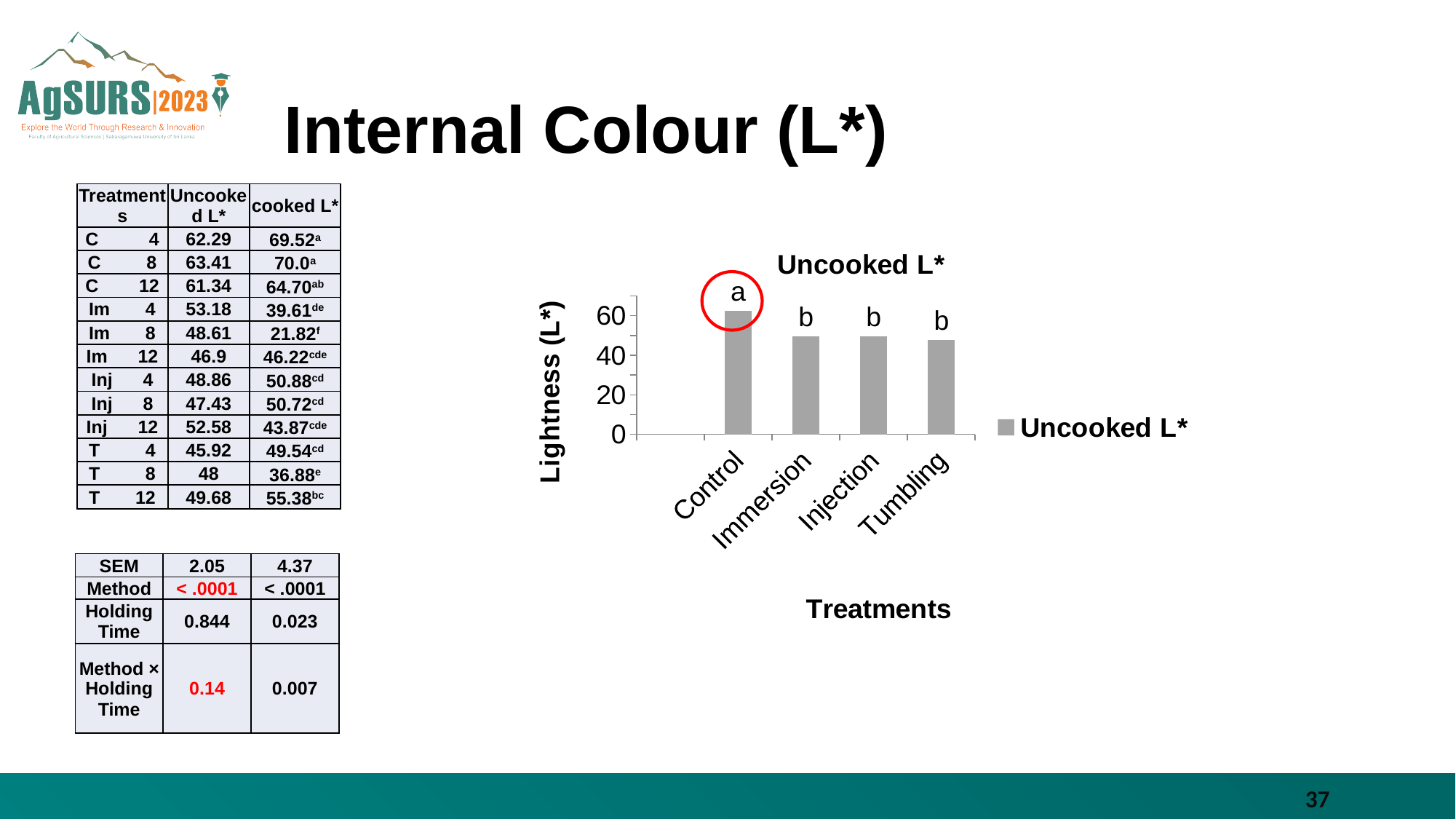
Which treatment has the highest Uncooked L* value in the chart? Control What kind of chart is shown on the slide? bar chart Is the Uncooked L* value for Immersion greater or less than 60? less Which has a larger Uncooked L* value, Tumbling or Control? Control Which has a larger Uncooked L* value, Control or Immersion? Control Is the Uncooked L* value for Injection greater or less than 20? greater What is the title of the chart? Uncooked L* How many treatment categories are plotted in the Uncooked L* chart? 4 Is the Uncooked L* value for Control greater or less than 40? greater What is the label of the vertical axis of the chart? Lightness (L*) How many series does the legend of the chart list? 1